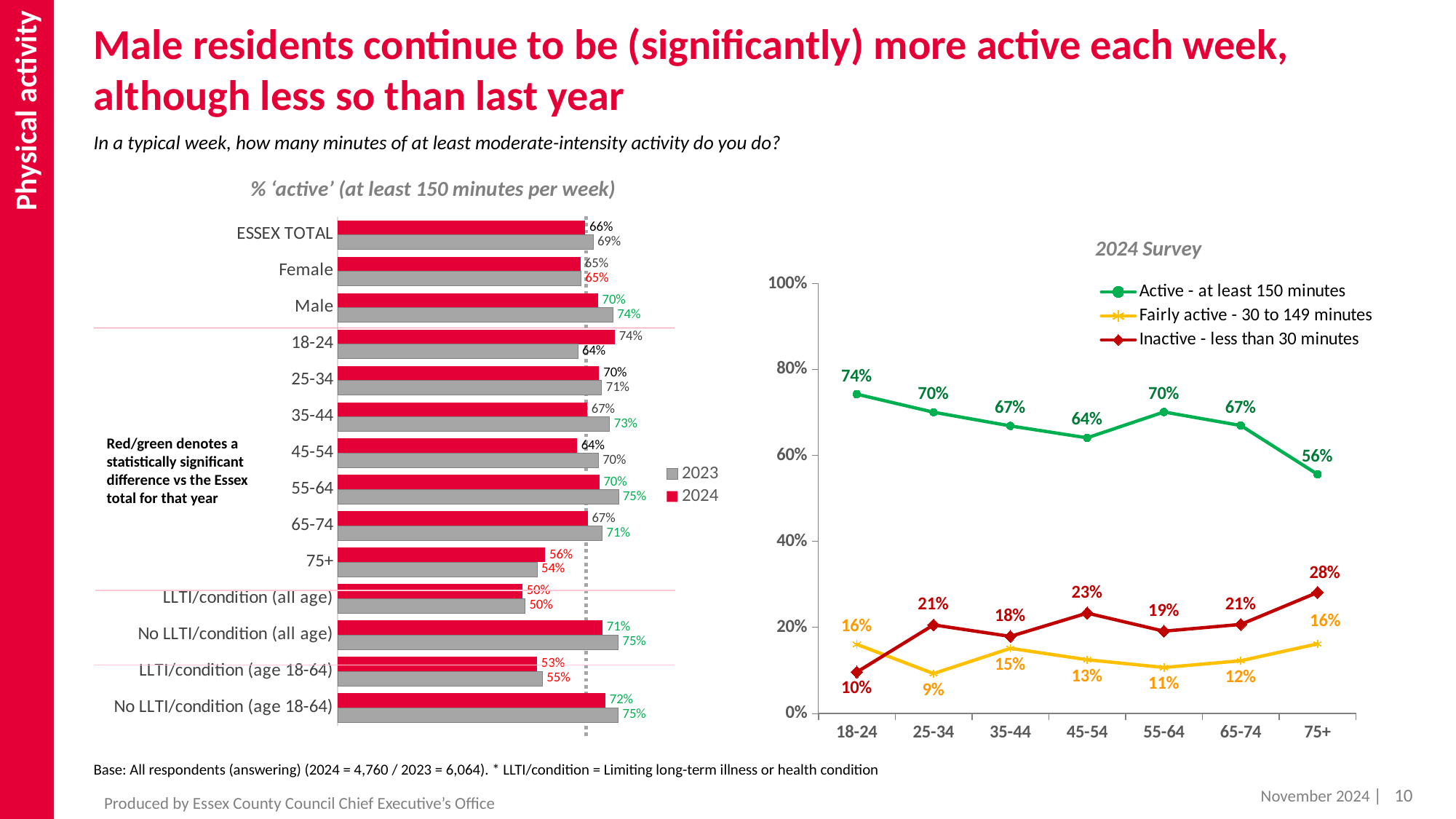
In the '% active (at least 150 minutes per week)' bar chart, which is larger for 55-64: the 2023 value or the 2024 value? 2023 In the '% active (at least 150 minutes per week)' bar chart, how many series does the legend list? 2 In the '2024 Survey' line chart, what is the difference between the 'Active' and 'Inactive' values for 45-54? 41 percentage points In the '% active (at least 150 minutes per week)' bar chart, what is the difference between the 2024 and 2023 values for 18-24? 10 percentage points In the '2024 Survey' line chart, which age group has the highest 'Active - at least 150 minutes' value? 18-24 In the '2024 Survey' line chart, which age group has the lowest 'Fairly active - 30 to 149 minutes' value? 25-34 In the '% active (at least 150 minutes per week)' bar chart, what is the 2024 value for Male? 70% What type of chart is the '% active (at least 150 minutes per week)' chart? Bar chart In the '2024 Survey' line chart, how many age groups are shown on the x axis? 7 In the '% active (at least 150 minutes per week)' bar chart, which category has the lowest 2024 value? LLTI/condition (all age) In the '2024 Survey' line chart, what is the 'Inactive - less than 30 minutes' value for 75+? 28% In the '% active (at least 150 minutes per week)' bar chart, what is the 2023 value for ESSEX TOTAL? 69%